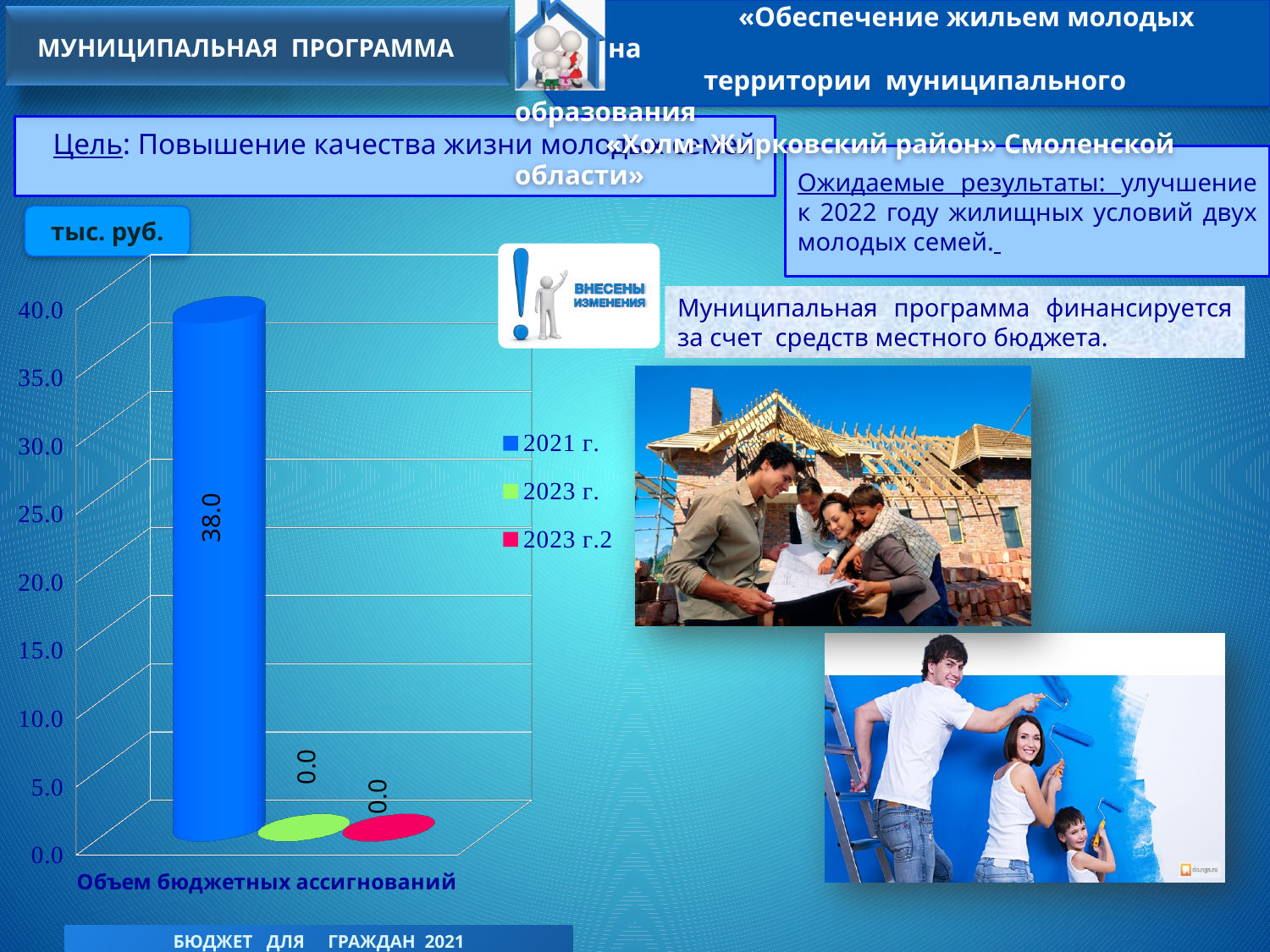
How many series does the chart legend list? 3 What is the highest tick value shown on the chart's vertical axis? 40.0 What is the difference between the 2021 г. value and the 2023 г. value? 38.0 What kind of chart is shown on the slide? bar chart Which series has the highest value in the chart? 2021 г. Which is larger, the value for 2021 г. or the value for 2023 г.2? 2021 г. What is the value for the 2023 г. series in the chart? 0.0 What is the category label shown below the chart's bars? Объем бюджетных ассигнований What is the value for the 2023 г.2 series in the chart? 0.0 Is the value for 2021 г. greater or less than 35.0? greater What unit is indicated for the chart values? тыс. руб. What is the value for the 2021 г. series in the chart? 38.0